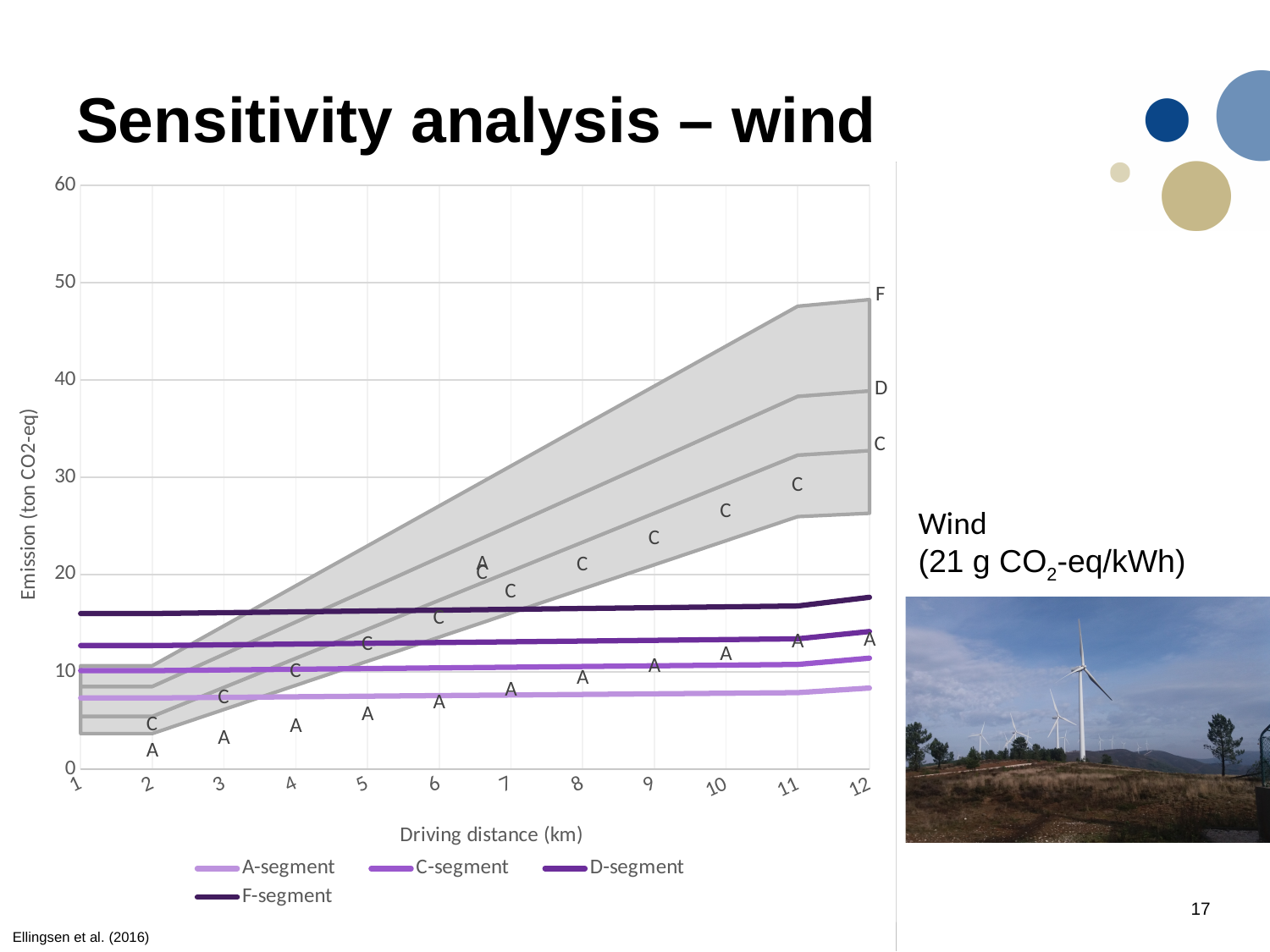
Is the F-segment value at 12 km greater or less than 20? less Which is larger at 12 km, the F-segment value or the A-segment value? F-segment Which segment line is the lowest across the driving distances? A-segment Does the upper edge of the grey shaded band rise or fall as driving distance increases? rise How many series does the chart legend list? 4 What is the label of the y axis? Emission (ton CO2-eq) What kind of chart is shown on the slide? combination area and line chart Is the A-segment value at 6 km greater or less than 10? less Is the F-segment value at 1 km greater or less than 10? greater Which segment line is the highest across the driving distances? F-segment How many driving distance values are shown on the x axis? 12